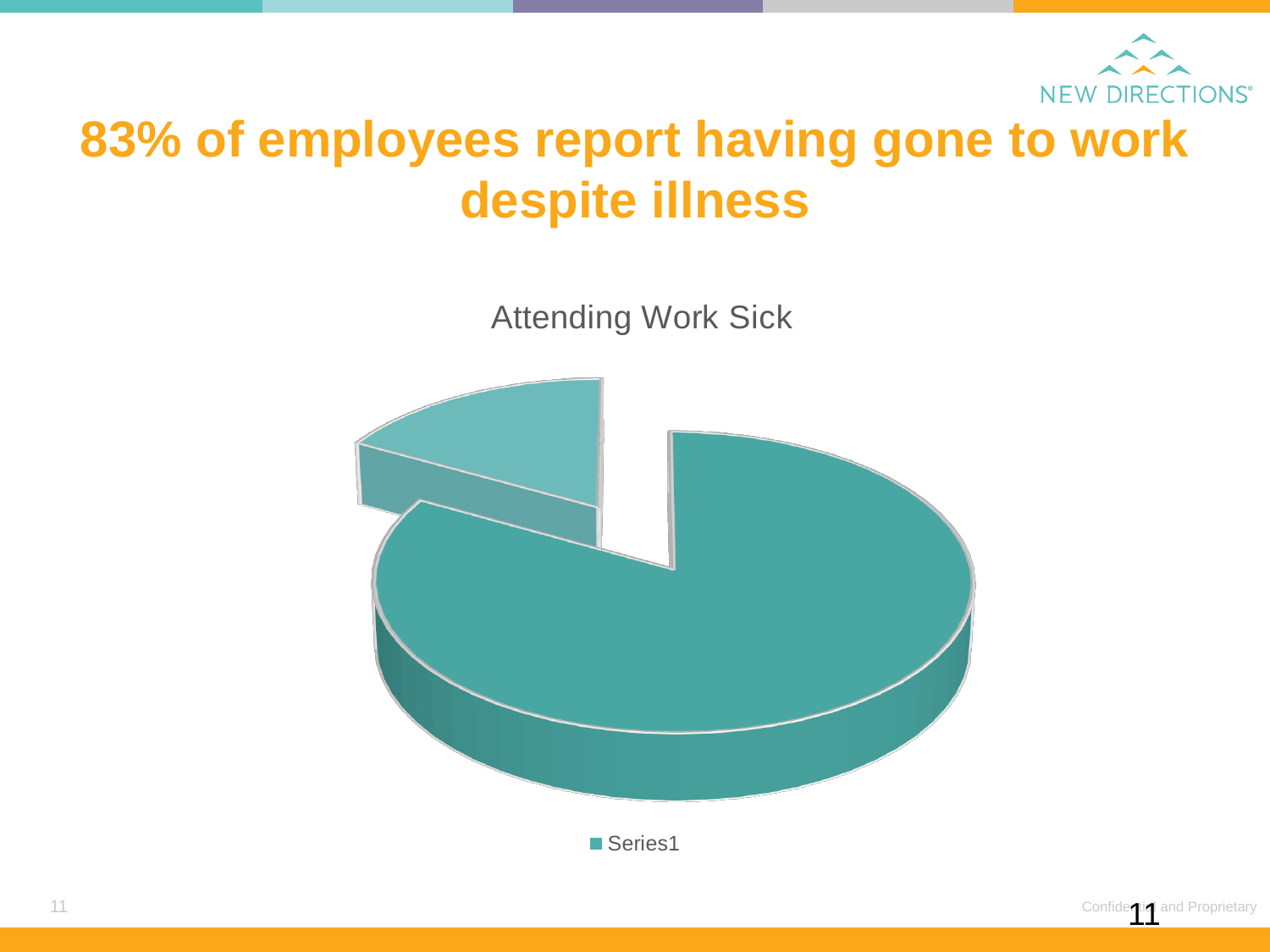
What is the legend entry shown below the pie chart? Series1 What kind of chart is shown on the slide? pie chart How many slices does the pie chart have? 2 Is the larger slice of the pie greater or less than half of the pie? greater How many series does the legend list? 1 Which slice is larger, the darker teal slice or the lighter, separated slice? the darker teal slice What is the title of the chart? Attending Work Sick According to the slide title, what percentage of employees report having gone to work despite illness? 83%